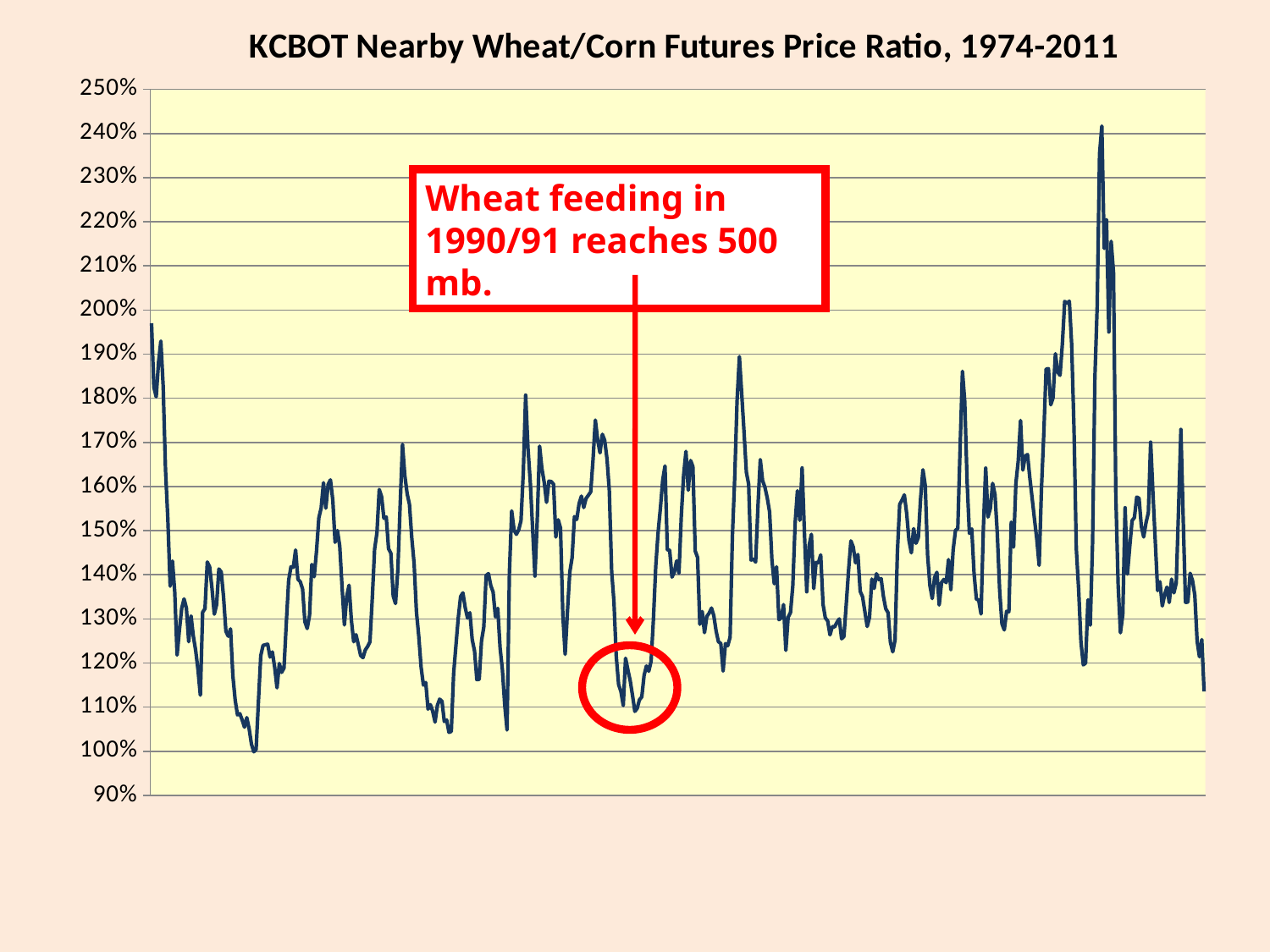
Is the value at the far right end of the line greater or less than 120%? less Is the lowest value reached by the line greater or less than 110%? less Is the value at the far left start of the line greater or less than 180%? greater What is the title of the chart? KCBOT Nearby Wheat/Corn Futures Price Ratio, 1974-2011 What does the red annotation box on the chart say? Wheat feeding in 1990/91 reaches 500 mb. What kind of chart is shown on the slide? line chart Which is larger, the peak near the right side of the chart or the peak near the left start of the line? the peak near the right side